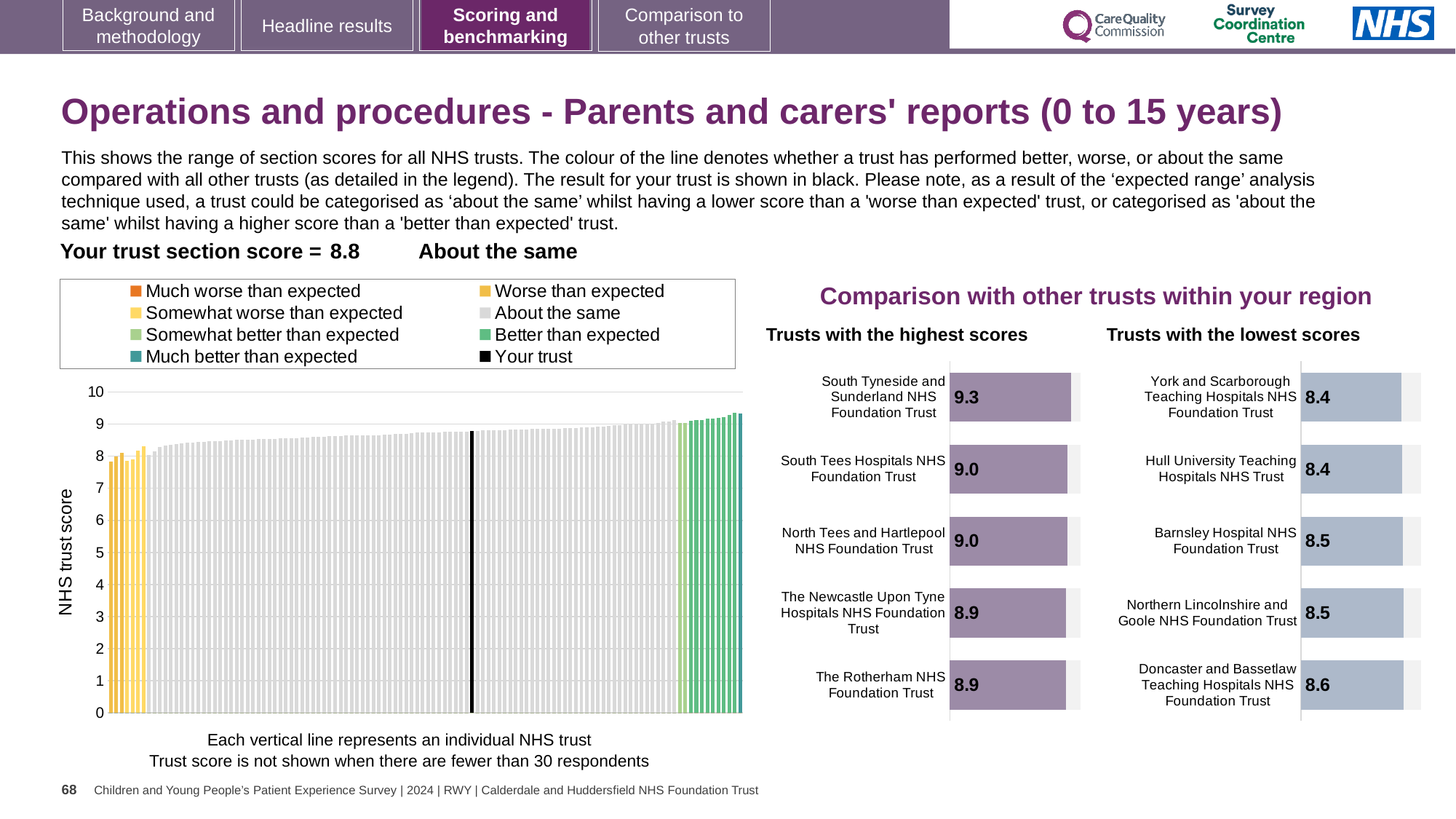
How many entries does the legend of the main chart on the left list? 8 In the 'Trusts with the lowest scores' chart, which trust has the highest score? Doncaster and Bassetlaw Teaching Hospitals NHS Foundation Trust In the 'Trusts with the lowest scores' chart, what is the difference between the scores of Doncaster and Bassetlaw Teaching Hospitals NHS Foundation Trust and York and Scarborough Teaching Hospitals NHS Foundation Trust? 0.2 In the 'Trusts with the highest scores' chart, what is the difference between the scores of South Tyneside and Sunderland NHS Foundation Trust and The Rotherham NHS Foundation Trust? 0.4 In the 'Trusts with the lowest scores' chart, what is the score for Doncaster and Bassetlaw Teaching Hospitals NHS Foundation Trust? 8.6 In the 'Trusts with the highest scores' chart, what is the score for South Tyneside and Sunderland NHS Foundation Trust? 9.3 In the 'Trusts with the highest scores' chart, which trust has the highest score? South Tyneside and Sunderland NHS Foundation Trust In the 'Trusts with the lowest scores' chart, which has the higher score: Barnsley Hospital NHS Foundation Trust or Hull University Teaching Hospitals NHS Trust? Barnsley Hospital NHS Foundation Trust In the main chart on the left, what is the section score for your trust (shown in black)? 8.8 What kind of chart is the 'Trusts with the highest scores' chart? Bar chart What is the y-axis label of the main chart on the left? NHS trust score How many trusts are shown in the 'Trusts with the highest scores' chart? 5